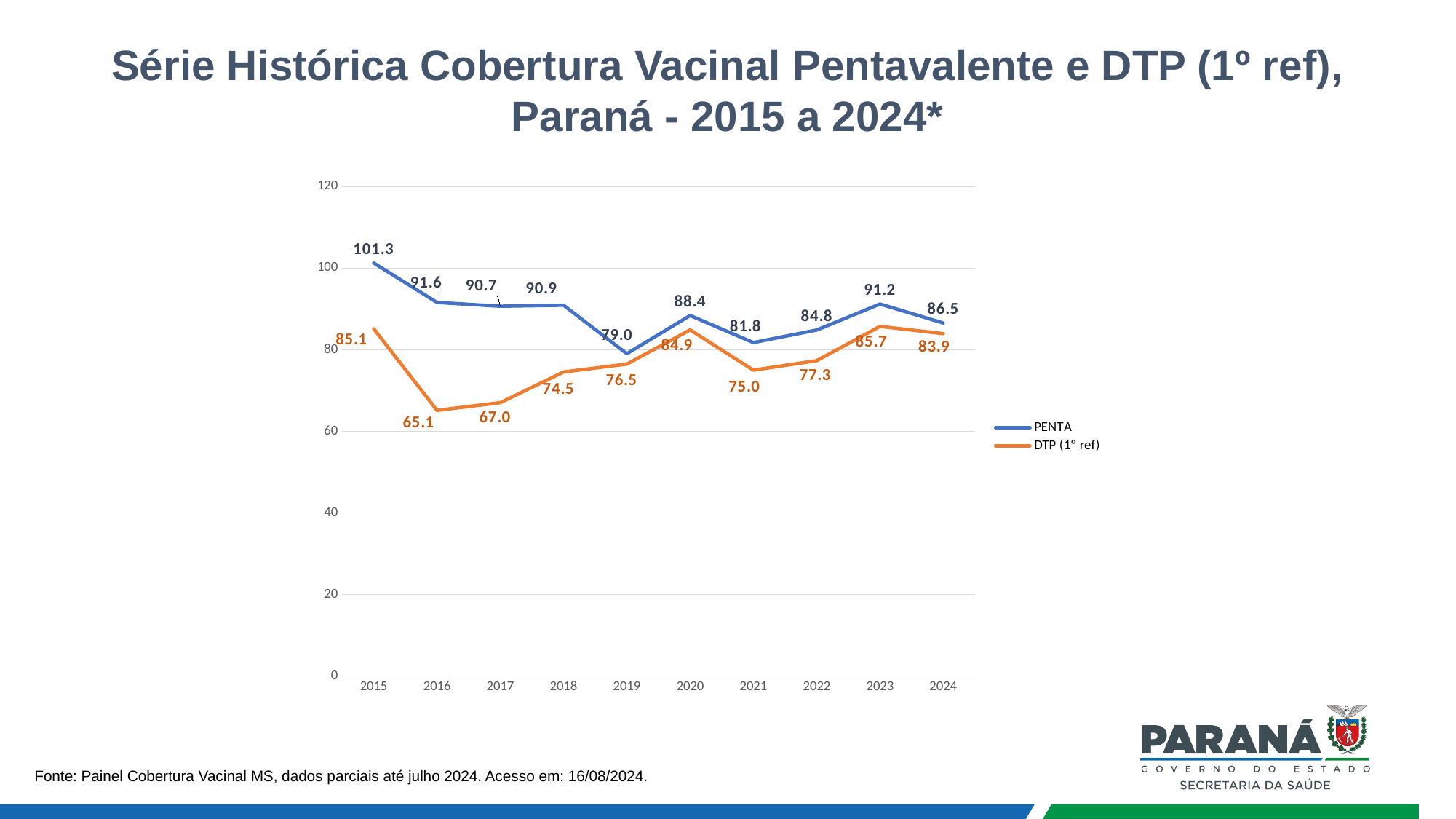
How many series does the legend list? 2 In which year is the DTP (1° ref) series at its lowest? 2016 What is the DTP (1° ref) value for 2024? 83.9 What is the DTP (1° ref) value for 2016? 65.1 How many years are shown on the x axis? 10 In which year is the PENTA series at its highest? 2015 What is the PENTA value for 2015? 101.3 Which colour is used for the DTP (1° ref) line? Orange Which series has the higher value in 2023, PENTA or DTP (1° ref)? PENTA What is the difference between the PENTA and DTP (1° ref) values in 2016? 26.5 What is the PENTA value for 2019? 79.0 What kind of chart is shown on the slide? Line chart